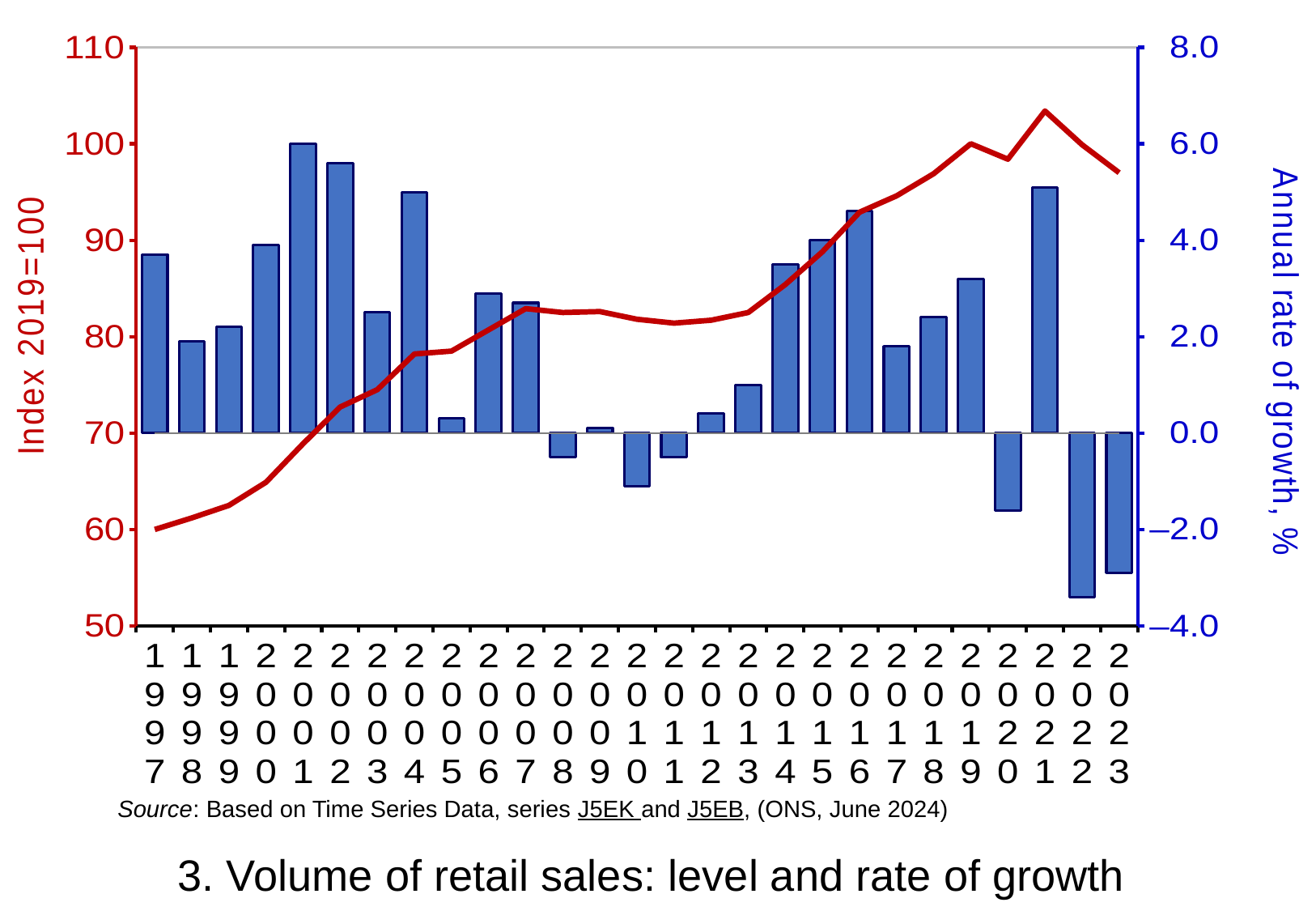
In which year is the annual rate of growth bar the highest? 2001 What is the label of the right-hand vertical axis? Annual rate of growth, % Does the red index line generally rise or fall from 1997 to 2021? rise What is the title of the chart? 3. Volume of retail sales: level and rate of growth Is the annual rate of growth bar for 2022 greater or less than -2.0? less Is the red index line value for 1997 greater or less than 70? less Which year has the larger annual rate of growth bar, 2004 or 2005? 2004 What is the value of the red index line in 2019? 100 Is the annual rate of growth bar for 2021 greater or less than 4.0? greater In which year is the annual rate of growth bar the lowest? 2022 What kind of chart is shown on the slide? A combined bar and line chart How many years are shown along the x axis? 27